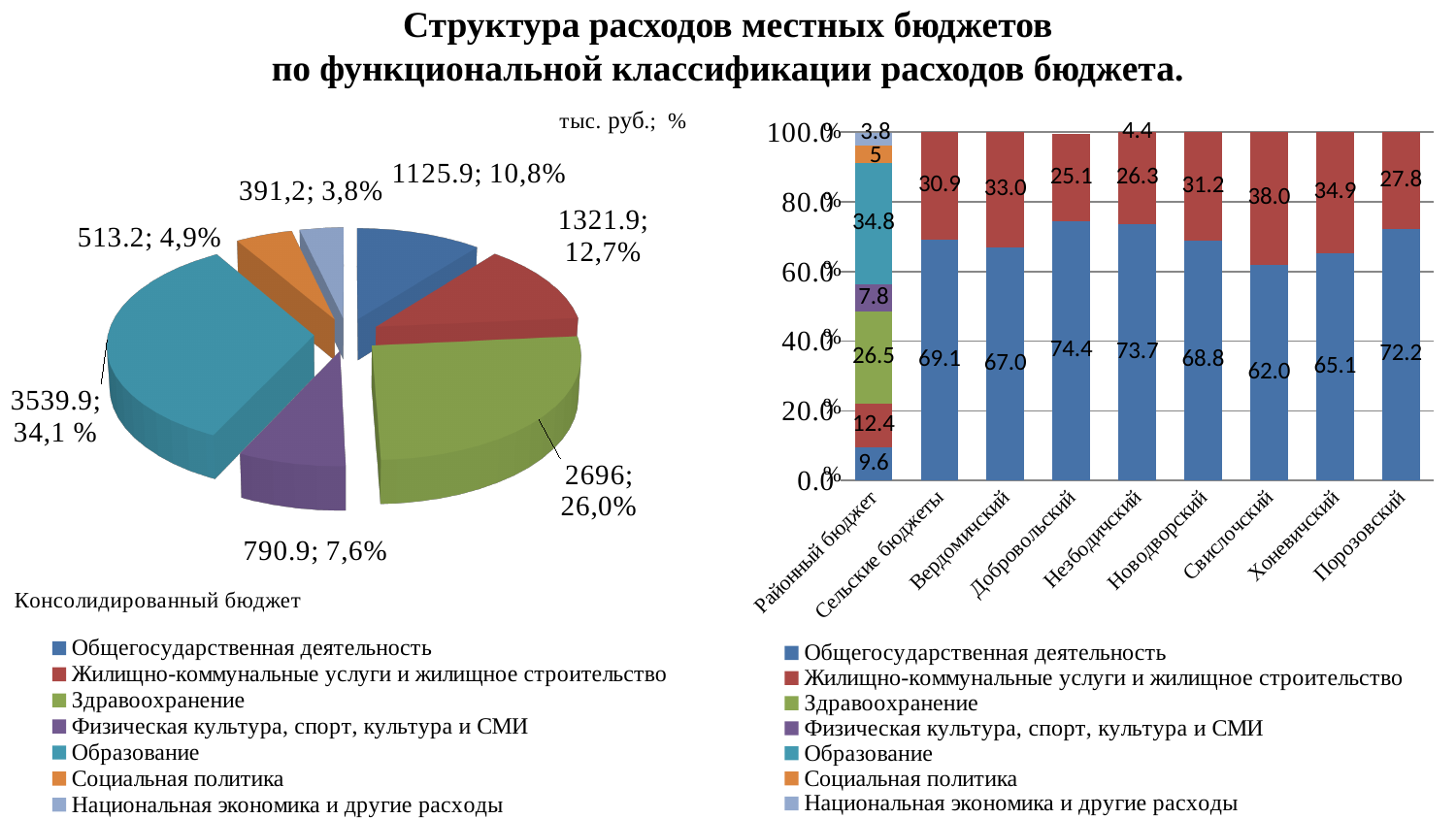
In the stacked bar chart on the right, which is larger: the Жилищно-коммунальные услуги value for Хоневичский or for Новодворский? Хоневичский In the pie chart on the left, how many slices are there? 7 In the stacked bar chart on the right, what is the value of Общегосударственная деятельность for Добровольский? 74.4 In the stacked bar chart on the right, which category has the highest value for Общегосударственная деятельность? Добровольский In the pie chart on the left, what is the value shown for Образование? 3539.9; 34,1 % In the stacked bar chart on the right, what is the value of Жилищно-коммунальные услуги и жилищное строительство for Свислочский? 38.0 In the pie chart on the left, what percentage share is shown for Здравоохранение? 26,0% In the stacked bar chart on the right, how many categories are shown on the x axis? 9 In the pie chart on the left, which category has the largest slice? Образование What type of chart is shown on the right side of the slide? Stacked bar chart In the pie chart on the left, which category has the smallest slice? Национальная экономика и другие расходы In the stacked bar chart on the right, what is the difference between the Общегосударственная деятельность values for Порозовский and Свислочский? 10.2